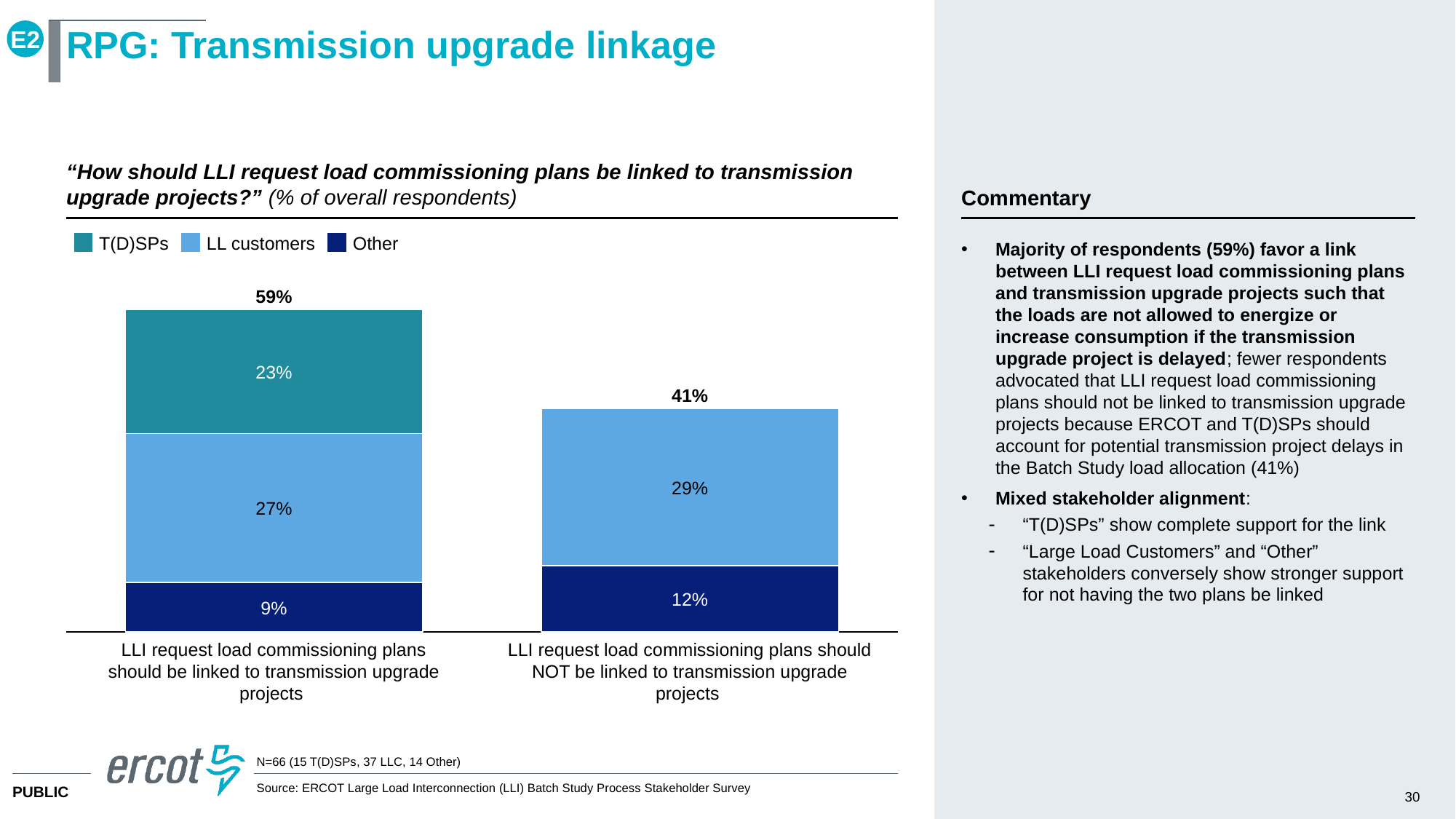
What is the total for the bar 'LLI request load commissioning plans should be linked to transmission upgrade projects'? 59% What is the T(D)SPs value for the bar 'LLI request load commissioning plans should be linked to transmission upgrade projects'? 23% How many categories (bars) are shown in the chart? 2 What is the LL customers value for the bar 'LLI request load commissioning plans should NOT be linked to transmission upgrade projects'? 29% Which legend entry is shown in the darkest blue colour? Other How many series does the legend list? 3 Which category has the higher total, 'should be linked' or 'should NOT be linked'? LLI request load commissioning plans should be linked to transmission upgrade projects What is the difference between the totals of the two bars (59% and 41%)? 18% What kind of chart is shown on the slide? Stacked bar chart What is the Other value for the bar 'LLI request load commissioning plans should be linked to transmission upgrade projects'? 9% Which is larger: the Other value for 'should be linked' (9%) or the Other value for 'should NOT be linked' (12%)? 12% for 'should NOT be linked' What is the total for the bar 'LLI request load commissioning plans should NOT be linked to transmission upgrade projects'? 41%